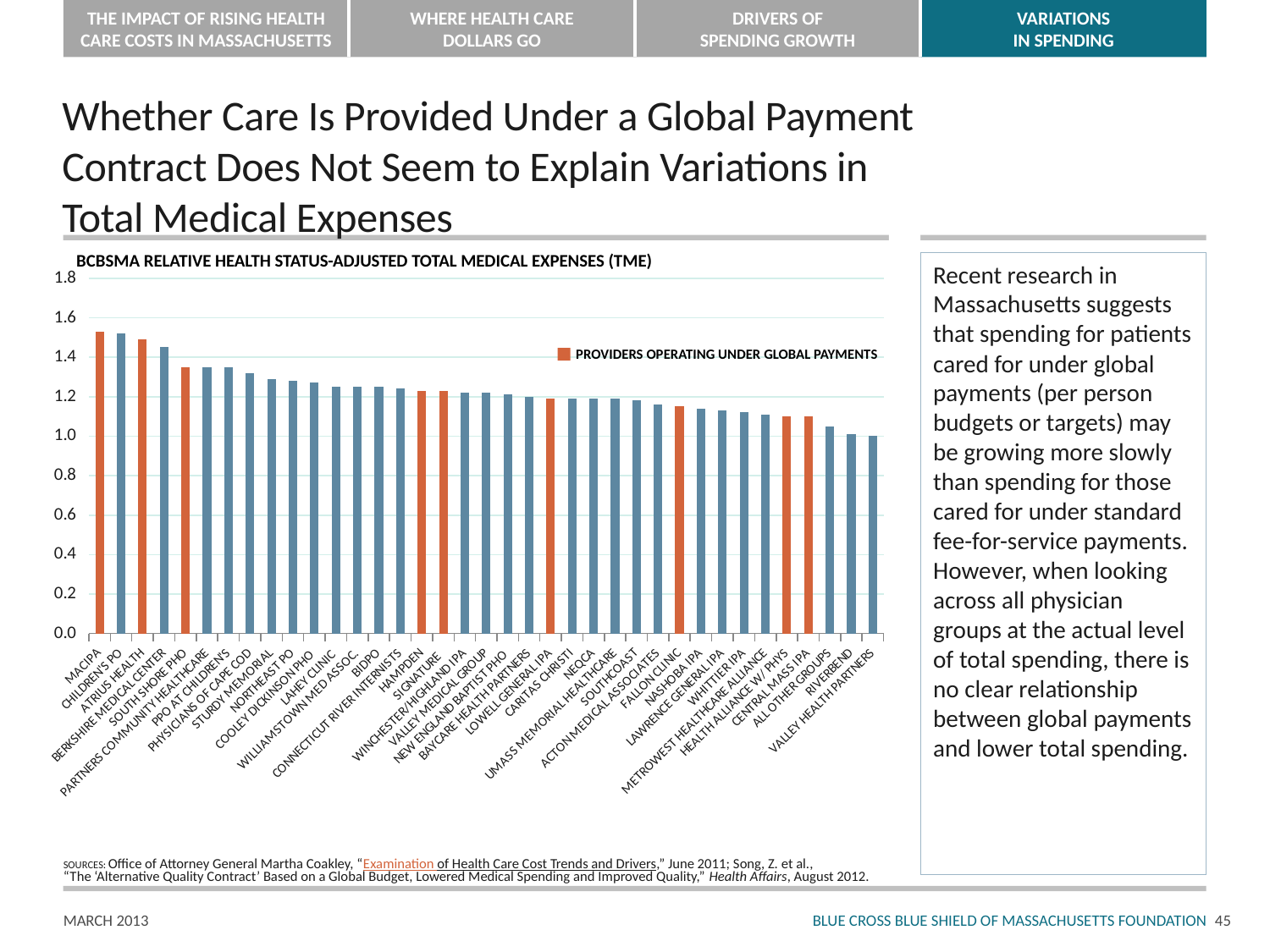
Is the value for FALLON CLINIC greater or less than 1.2? less Is the value for ALL OTHER GROUPS greater or less than 1.2? less What kind of chart is shown on the slide? bar chart What does the orange colour in the chart's legend indicate? PROVIDERS OPERATING UNDER GLOBAL PAYMENTS What is the title of the chart? BCBSMA RELATIVE HEALTH STATUS-ADJUSTED TOTAL MEDICAL EXPENSES (TME) Do the values rise or fall moving from left to right along the x axis? fall Which has the larger value, MACIPA or VALLEY HEALTH PARTNERS? MACIPA Is the value for MACIPA greater or less than 1.4? greater Which has the larger value, ATRIUS HEALTH or FALLON CLINIC? ATRIUS HEALTH